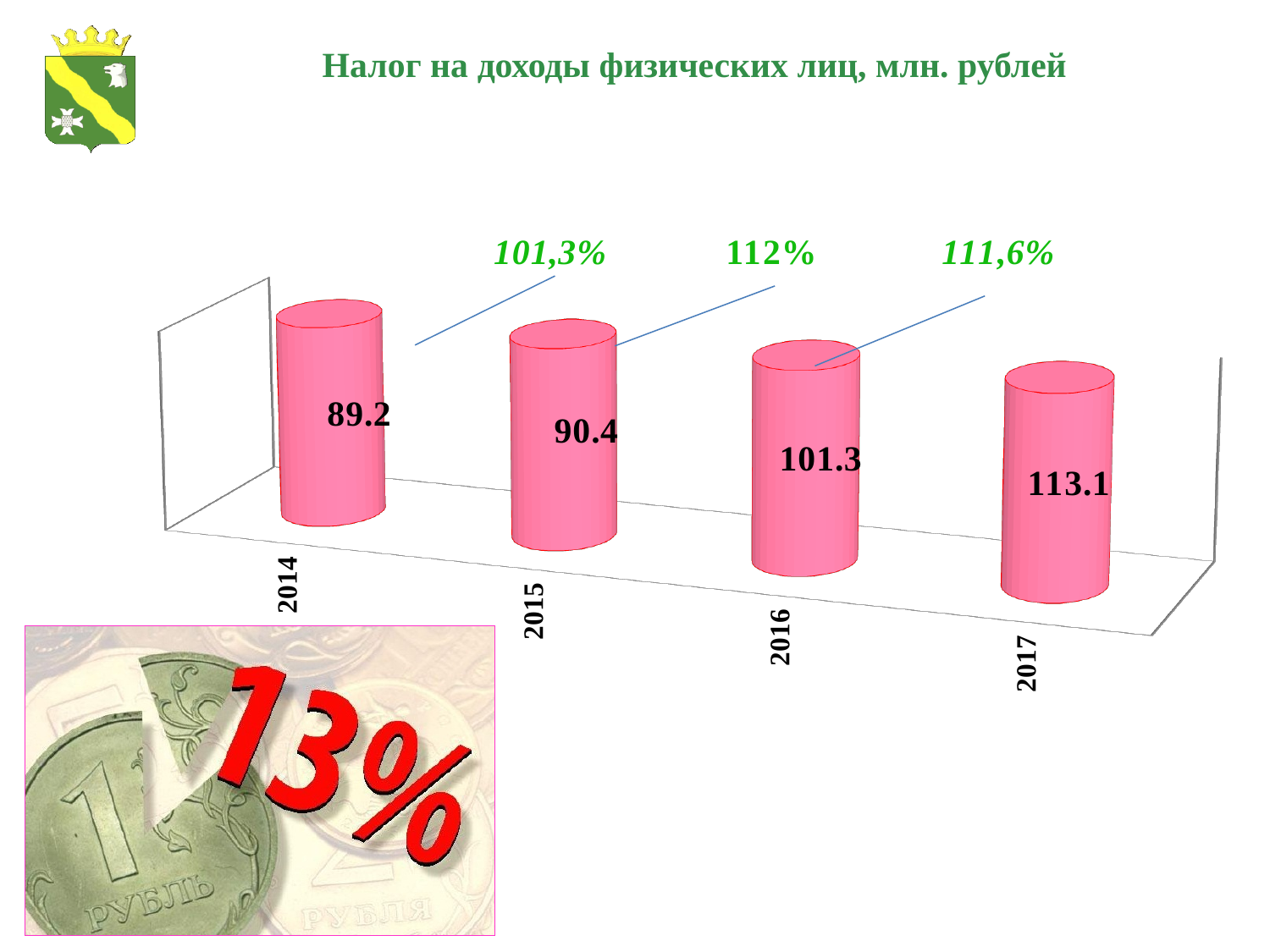
What is the difference between the values for 2017 and 2014? 23.9 Which year has the lowest value? 2014 What is the difference between the values for 2016 and 2015? 10.9 Do the values rise or fall from 2014 to 2017? rise What kind of chart is shown on the slide? bar chart What growth percentage is annotated above the 2016 bar? 112% What is the value for 2014? 89.2 Which year has the highest value? 2017 What is the value for 2017? 113.1 What is the value for 2016? 101.3 Which is larger, the value for 2015 or the value for 2016? 2016 How many years are shown on the chart? 4